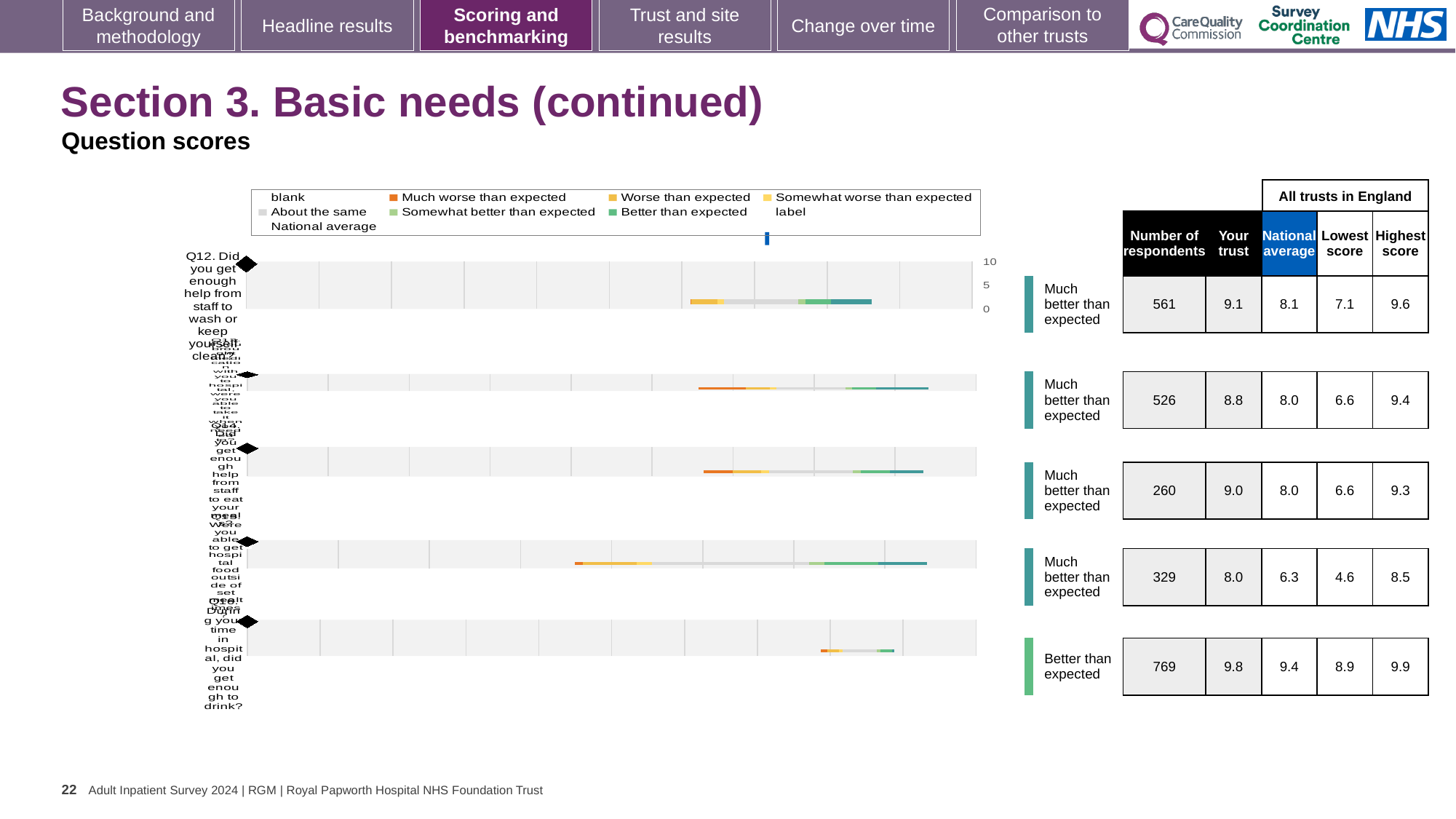
In the chart legend, which colour represents 'Much worse than expected'? orange Which row has the lowest 'Your trust' score? Q15 (hospital food outside of set meal times), 8.0 What kind of chart is shown on the slide? bar chart What benchmark category is shown for the last row, Q16 (did you get enough to drink)? Better than expected What is the lowest score among all trusts in England for Q15 (hospital food outside of set meal times)? 4.6 For Q16 (did you get enough to drink), which is larger: the 'Your trust' score or the national average? Your trust How many respondents answered the last row, Q16 (did you get enough to drink)? 769 What is the national average for Q12 (help from staff to wash or keep yourself clean)? 8.1 What is the difference between the 'Your trust' score and the national average for Q12? 1.0 Which row has the highest 'Your trust' score? Q16 (did you get enough to drink), 9.8 What is the 'Your trust' score for the first row, Q12 (help from staff to wash or keep yourself clean)? 9.1 How many question rows (bars) does the chart show? 5